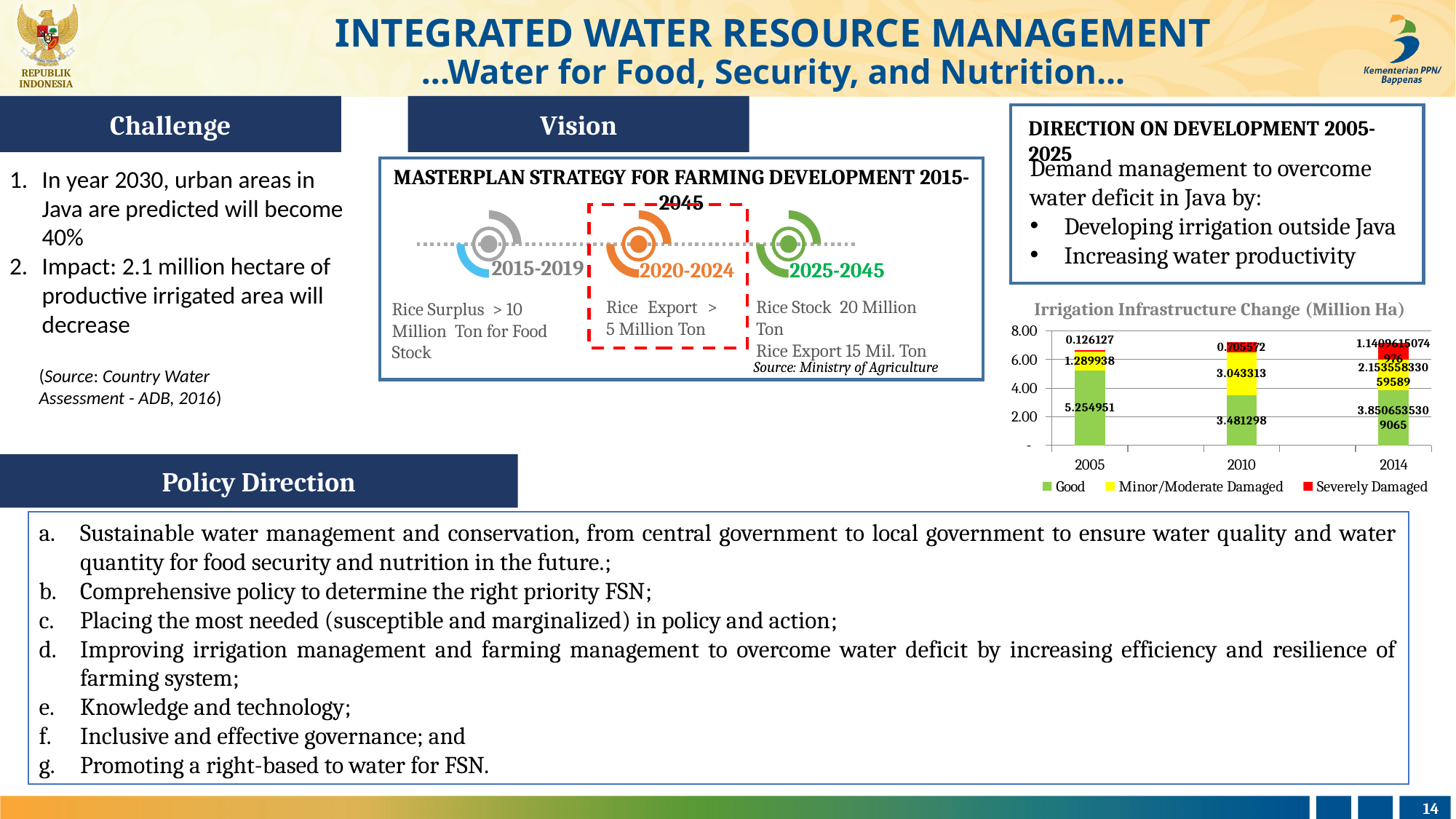
In the 'Irrigation Infrastructure Change' chart, what is the Good value for 2005? 5.254951 In the 'Irrigation Infrastructure Change' chart, is the total height of the 2014 bar greater or less than 6.00? greater How many series does the legend of the 'Irrigation Infrastructure Change' chart list? 3 How many years are shown on the x axis of the 'Irrigation Infrastructure Change' chart? 3 In the 'Irrigation Infrastructure Change' chart, what is the total of the stacked bar for 2005? 6.671016 In the 'Irrigation Infrastructure Change' chart, which year has the highest Good value? 2005 In the 'Irrigation Infrastructure Change' chart, does the Severely Damaged value rise or fall from 2005 to 2014? rise In the 'Irrigation Infrastructure Change' chart, is the Severely Damaged value larger in 2005 or 2010? 2010 In the 'Irrigation Infrastructure Change' chart, what is the Severely Damaged value for 2005? 0.126127 What kind of chart is 'Irrigation Infrastructure Change (Million Ha)'? Stacked bar chart In the 'Irrigation Infrastructure Change' chart, what is the Minor/Moderate Damaged value for 2010? 3.043313 In the 'Irrigation Infrastructure Change' chart, what is the difference between the Good value in 2005 and in 2010? 1.773653